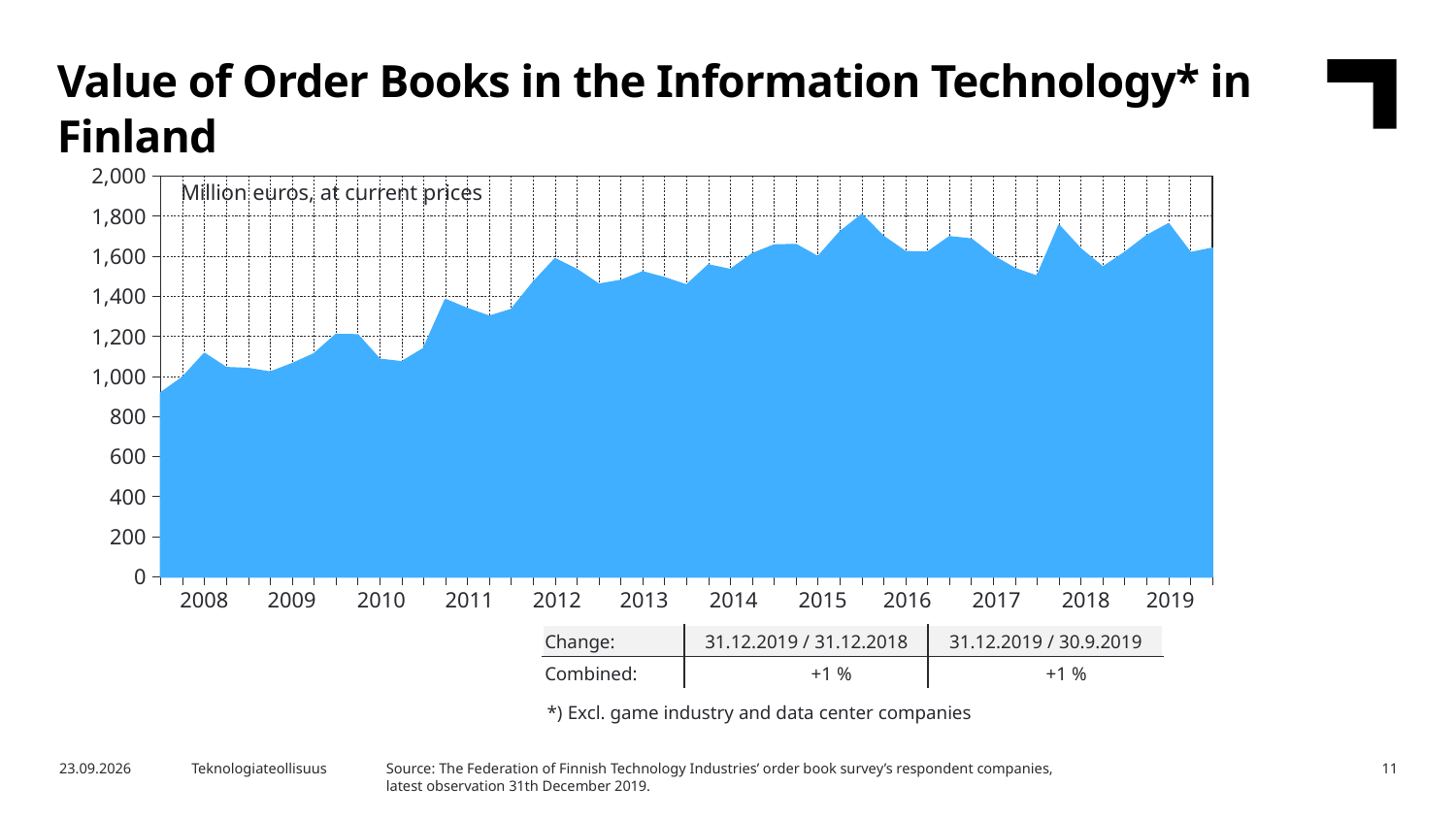
Is the peak value reached in 2015 greater or less than 1,600? greater What is the highest value shown on the y axis of the chart? 2,000 In what unit are the values on the chart expressed, according to the label inside the plot area? Million euros, at current prices Which is larger, the value at the start of 2008 or the value at the end of 2019? End of 2019 Is the value at the start of 2013 greater or less than 1,200? greater How many year labels are shown along the x axis of the chart? 12 What kind of chart is shown on the slide? Area chart Is the value at the start of 2008 greater or less than 1,000? less What is the title of the chart on the slide? Value of Order Books in the Information Technology* in Finland Overall, do the values rise or fall from 2008 to 2019? rise